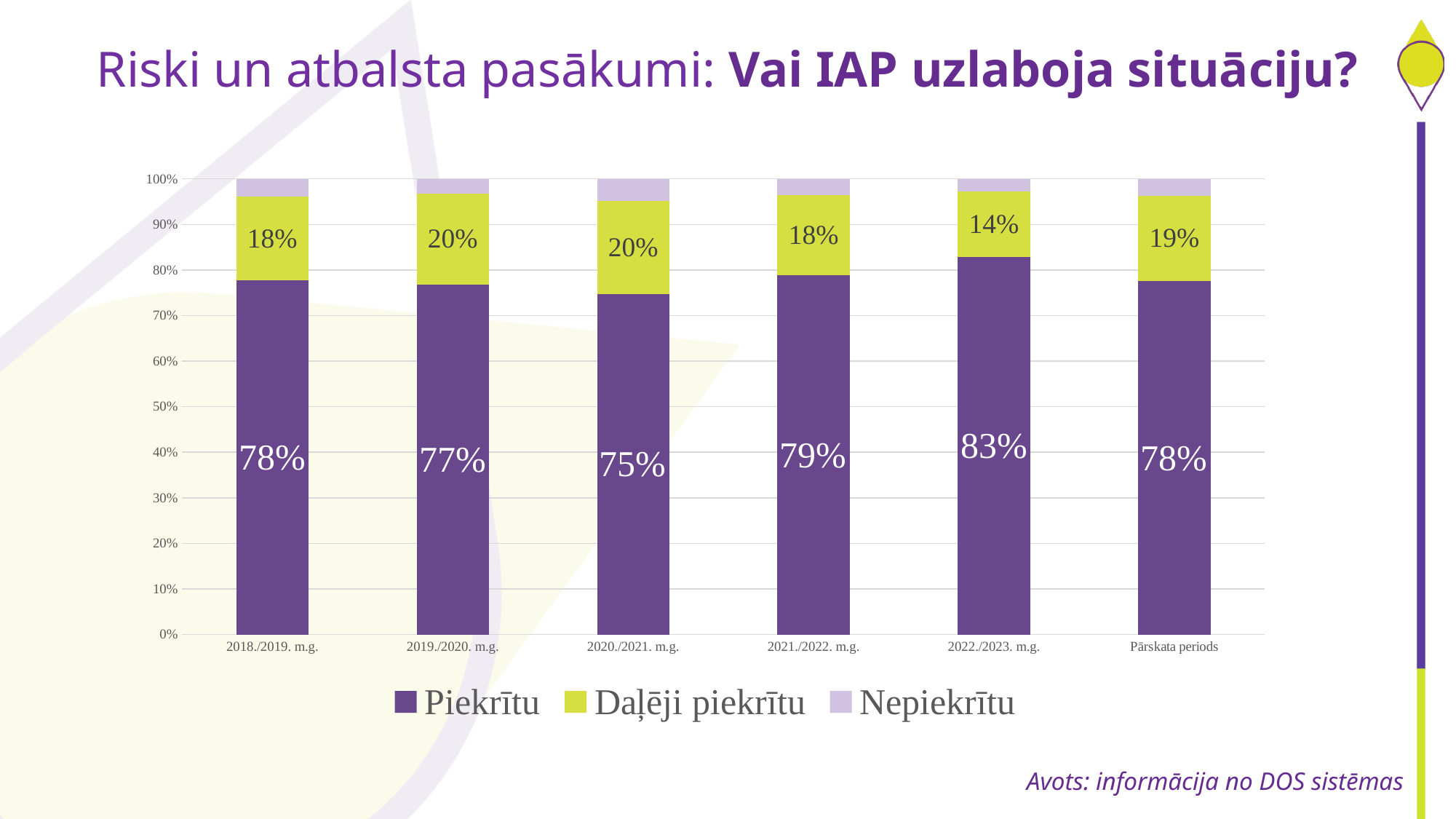
Which period has the lowest value for Piekrītu? 2020./2021. m.g. What is the difference between the Piekrītu values for 2022./2023. m.g. and 2020./2021. m.g.? 8% What is the value for Piekrītu in 2022./2023. m.g.? 83% How many periods are shown on the x axis? 6 What is the value for Piekrītu in Pārskata periods? 78% What is the value for Daļēji piekrītu in 2019./2020. m.g.? 20% What kind of chart is shown on the slide? Stacked bar chart Which period has the lowest value for Daļēji piekrītu? 2022./2023. m.g. Which is larger: the Piekrītu value for 2021./2022. m.g. or for 2019./2020. m.g.? 2021./2022. m.g. Is the Piekrītu value for 2020./2021. m.g. greater or less than 80%? less How many series does the legend list? 3 Which period has the highest value for Piekrītu? 2022./2023. m.g.